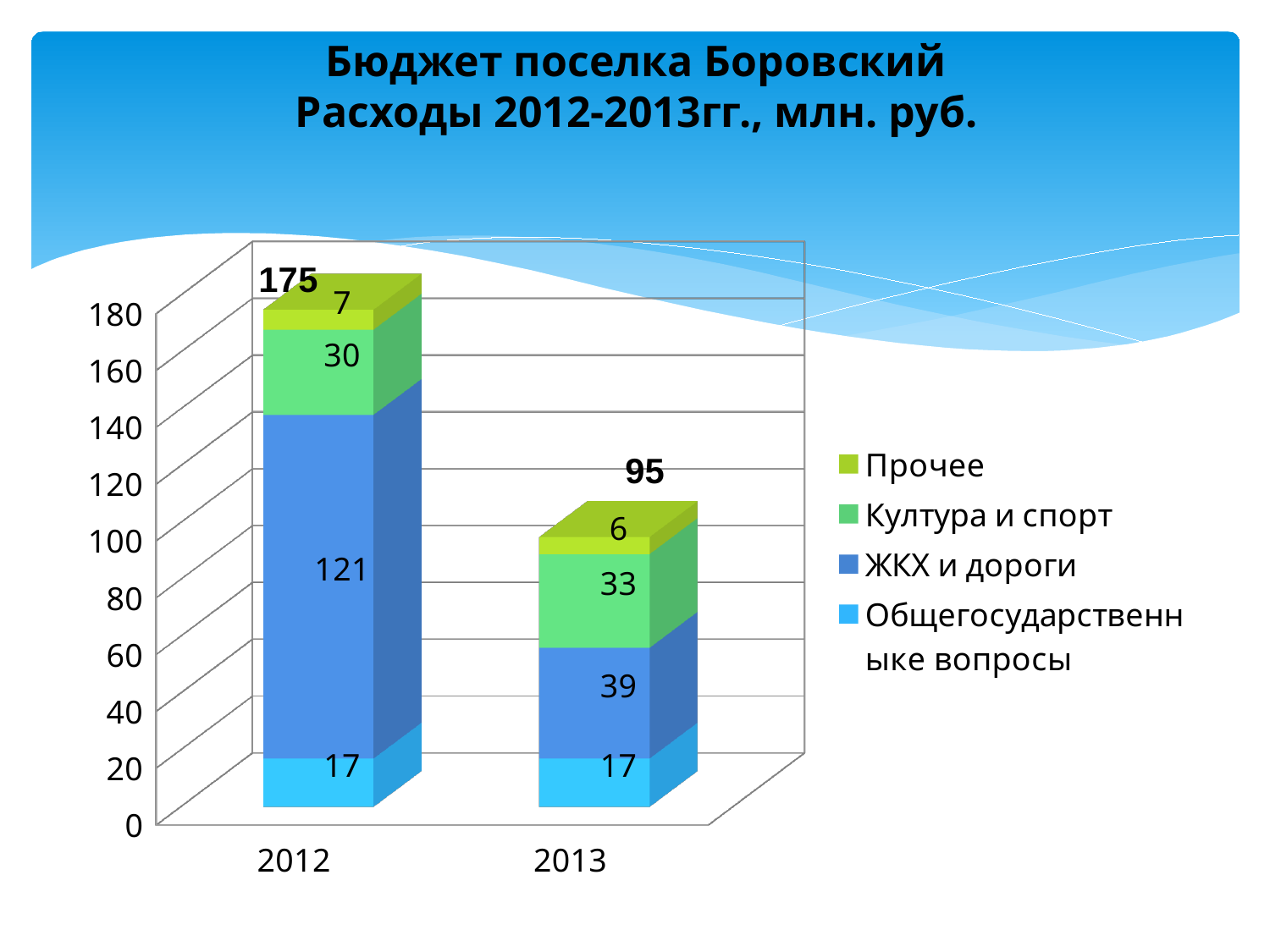
What is the total of the stacked bar for 2013? 95 What is the value for ЖКХ и дороги in 2012? 121 Which year has the larger value for Култура и спорт, 2012 or 2013? 2013 How many series does the legend list? 4 What is the value for Култура и спорт in 2013? 33 What is the difference between the ЖКХ и дороги values for 2012 and 2013? 82 What kind of chart is shown on the slide? Stacked bar chart What is the total of the stacked bar for 2012? 175 What is the value for Прочее in 2012? 7 Which year has the highest total expenditure? 2012 What is the value for Общегосударственныке вопросы in 2013? 17 How many categories are shown on the x axis? 2